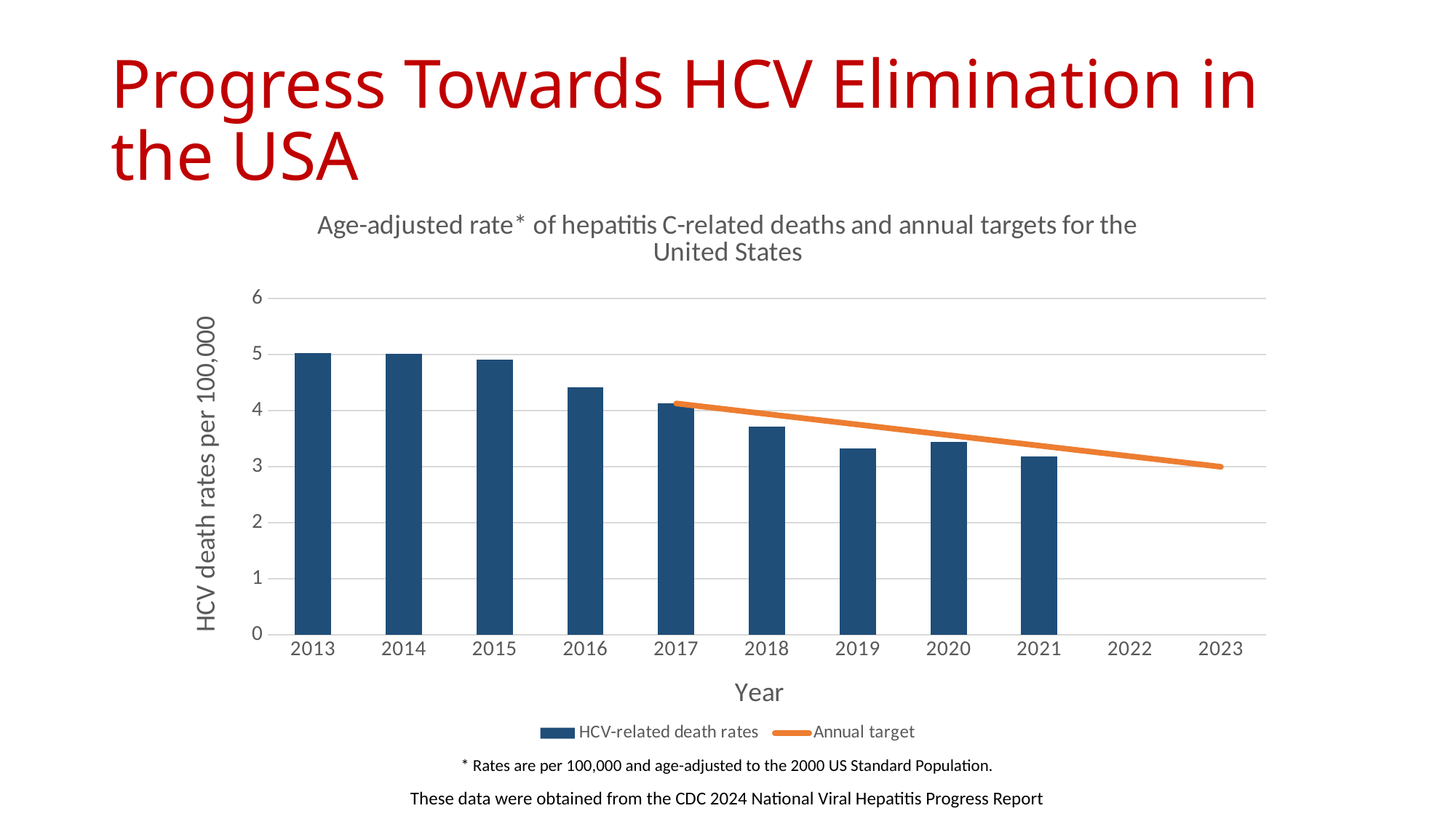
Is the HCV-related death rate for 2013 greater or less than 4? greater How many years have a bar plotted for HCV-related death rates? 9 Which year has the higher HCV-related death rate, 2016 or 2019? 2016 Which year has the higher HCV-related death rate, 2013 or 2021? 2013 Is the HCV-related death rate for 2018 greater or less than 4? less What is the label on the y axis of the chart? HCV death rates per 100,000 Is the HCV-related death rate for 2019 greater or less than 3? greater Do the HCV-related death rates rise or fall from 2013 to 2021? Fall How many series does the legend list? 2 What kind of chart is shown on the slide? Bar chart (with a target line)